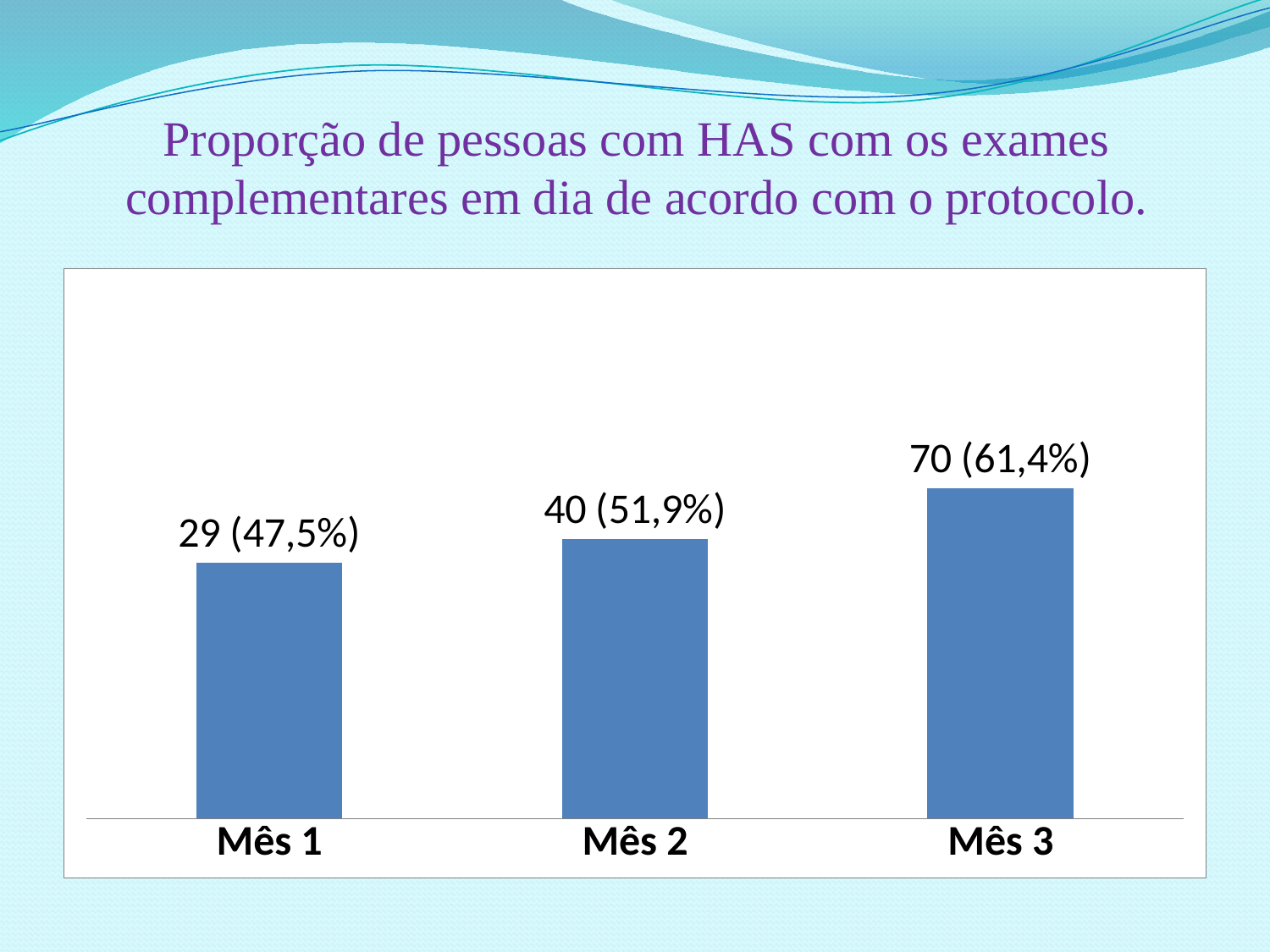
Which month has the highest bar? Mês 3 What percentage is shown for Mês 3? 61,4% What is the data label shown for Mês 1? 29 (47,5%) Which is larger, the value for Mês 2 or the value for Mês 3? Mês 3 What is the difference between the counts for Mês 3 and Mês 1? 41 What is the difference between the counts for Mês 2 and Mês 1? 11 How many months (categories) are shown on the x axis? 3 Which month has the lowest bar? Mês 1 What is the data label shown for Mês 3? 70 (61,4%) What kind of chart is shown on the slide? Bar chart Do the values rise or fall from Mês 1 to Mês 3? Rise What is the data label shown for Mês 2? 40 (51,9%)